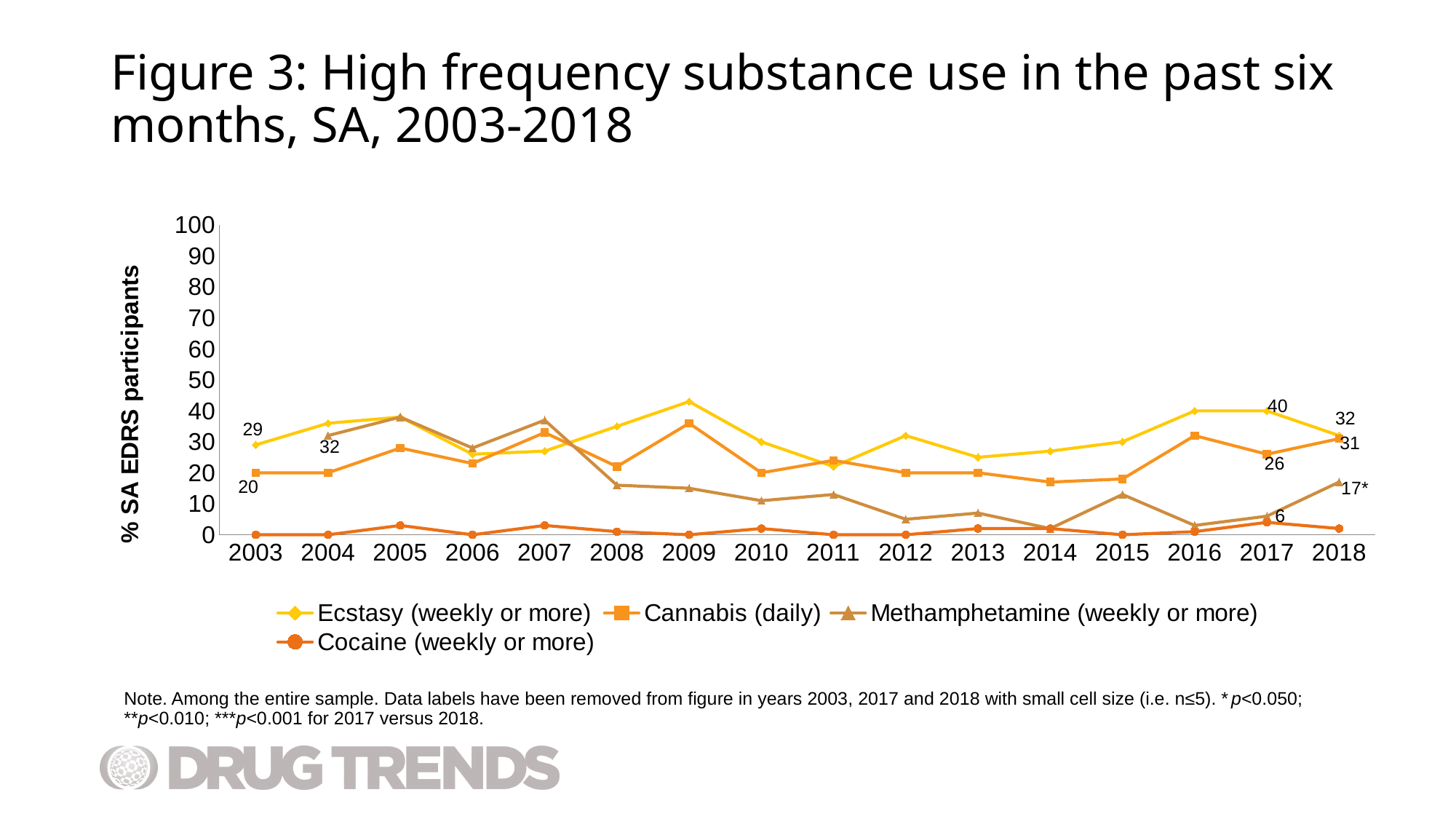
Which series has the highest value in 2017? Ecstasy (weekly or more) What is the value for Cannabis (daily) in 2003? 20 What kind of chart is shown on the slide? line chart What is the value for Ecstasy (weekly or more) in 2003? 29 What is the value for Cannabis (daily) in 2018? 31 What is the value for Ecstasy (weekly or more) in 2017? 40 What is the label on the y axis? % SA EDRS participants Is the value for Cocaine (weekly or more) in 2009 greater or less than 10? less How many series does the legend list? 4 How many years are shown along the x axis? 16 What is the value for Methamphetamine (weekly or more) in 2018? 17* By how much did the value for Ecstasy (weekly or more) change from 2017 to 2018? 8